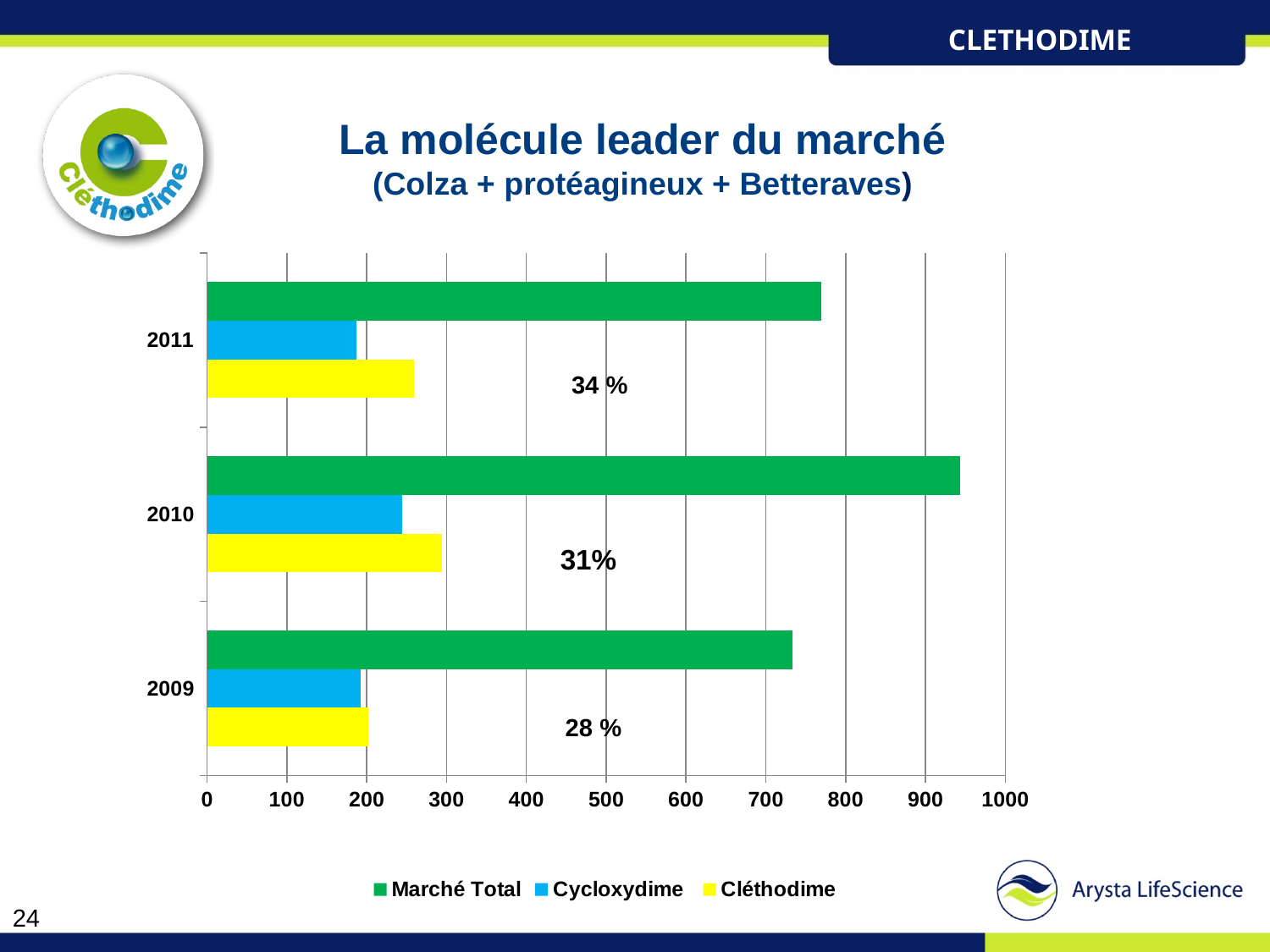
What percentage label is printed next to the 2009 bars? 28 % Is the Marché Total value for 2010 greater or less than 900? greater What kind of chart is shown on the slide? bar chart Which year has the highest Marché Total value? 2010 Which colour represents Cléthodime in the legend? yellow Is the Marché Total value for 2011 greater or less than 800? less How many series does the legend list? 3 Is the Marché Total value for 2009 greater or less than 700? greater In 2011, which is larger: Cycloxydime or Cléthodime? Cléthodime What percentage label is printed next to the 2011 bars? 34 % How many years are shown on the chart? 3